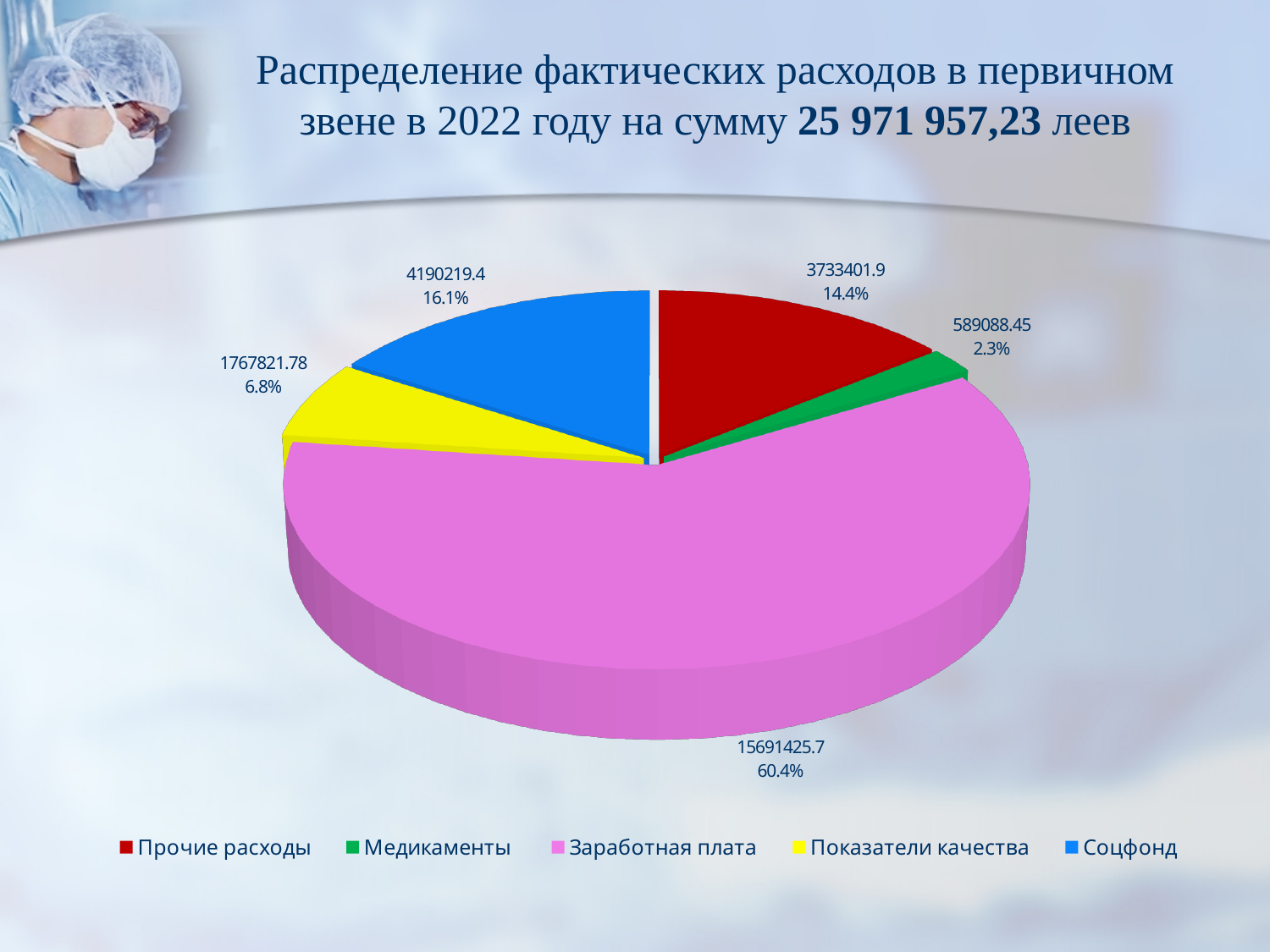
What is the value for Соцфонд? 4190219.4 What share of the pie does Заработная плата represent? 60.4% What is the value for Заработная плата? 15691425.7 Which category has the largest slice? Заработная плата What is the value for Медикаменты? 589088.45 What type of chart is shown on the slide? pie chart What share of the pie does Прочие расходы represent? 14.4% What colour is the slice for Показатели качества? yellow What is the value for Показатели качества? 1767821.78 How many categories does the legend list? 5 Which category has the smallest slice? Медикаменты Which is larger, Соцфонд or Прочие расходы? Соцфонд